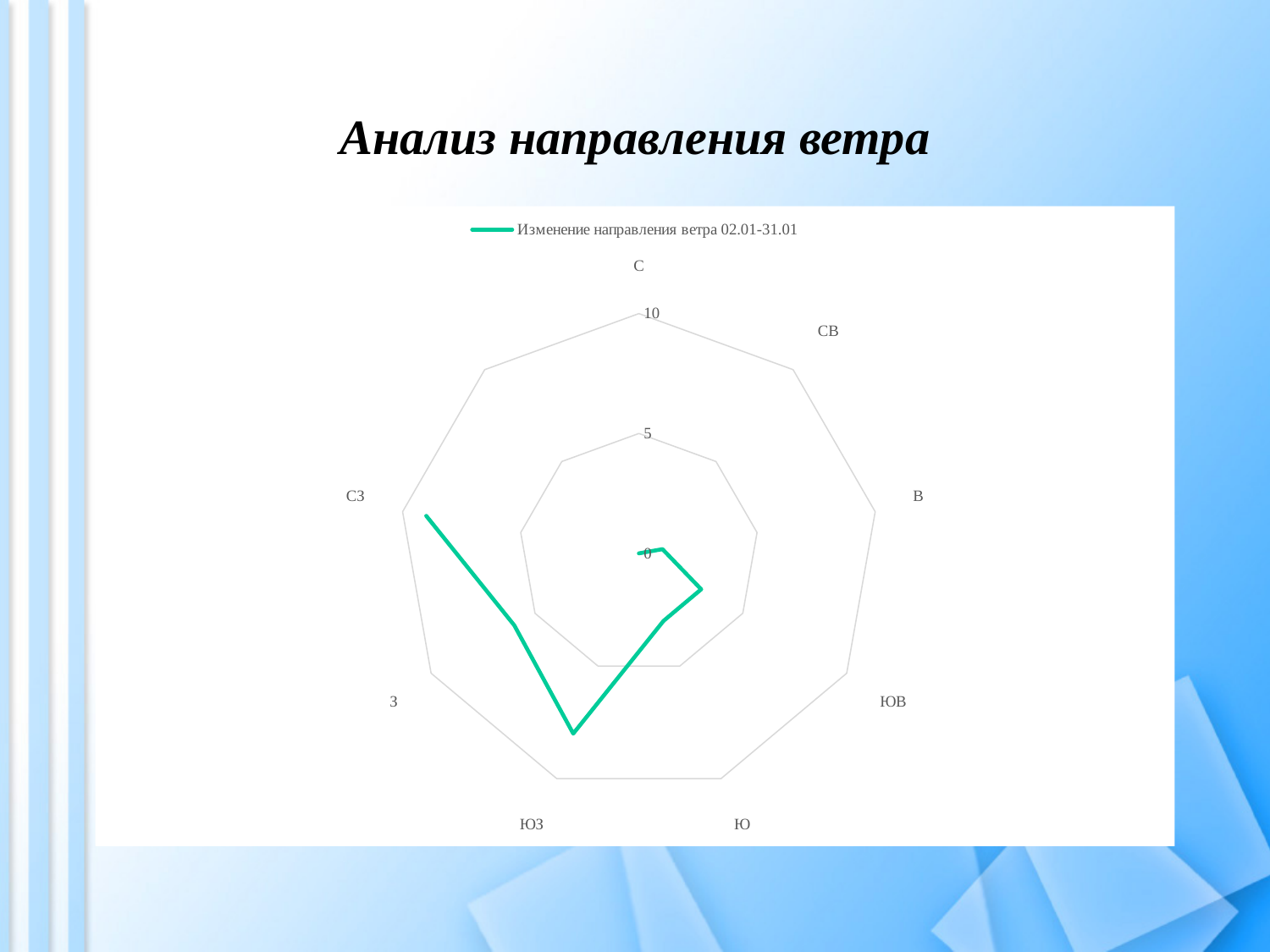
Which has the larger value, ЮЗ or Ю? ЮЗ How many series does the legend list? 1 Is the value for ЮВ greater or less than 5? less Is the value for ЮЗ greater or less than 5? greater What is the value for С (north)? 0 What kind of chart is shown on the slide? radar chart Is the value for Ю greater or less than 5? less What is the title of the slide above the chart? Анализ направления ветра Which has the larger value, СЗ or З? СЗ What is the legend entry for the plotted series? Изменение направления ветра 02.01-31.01